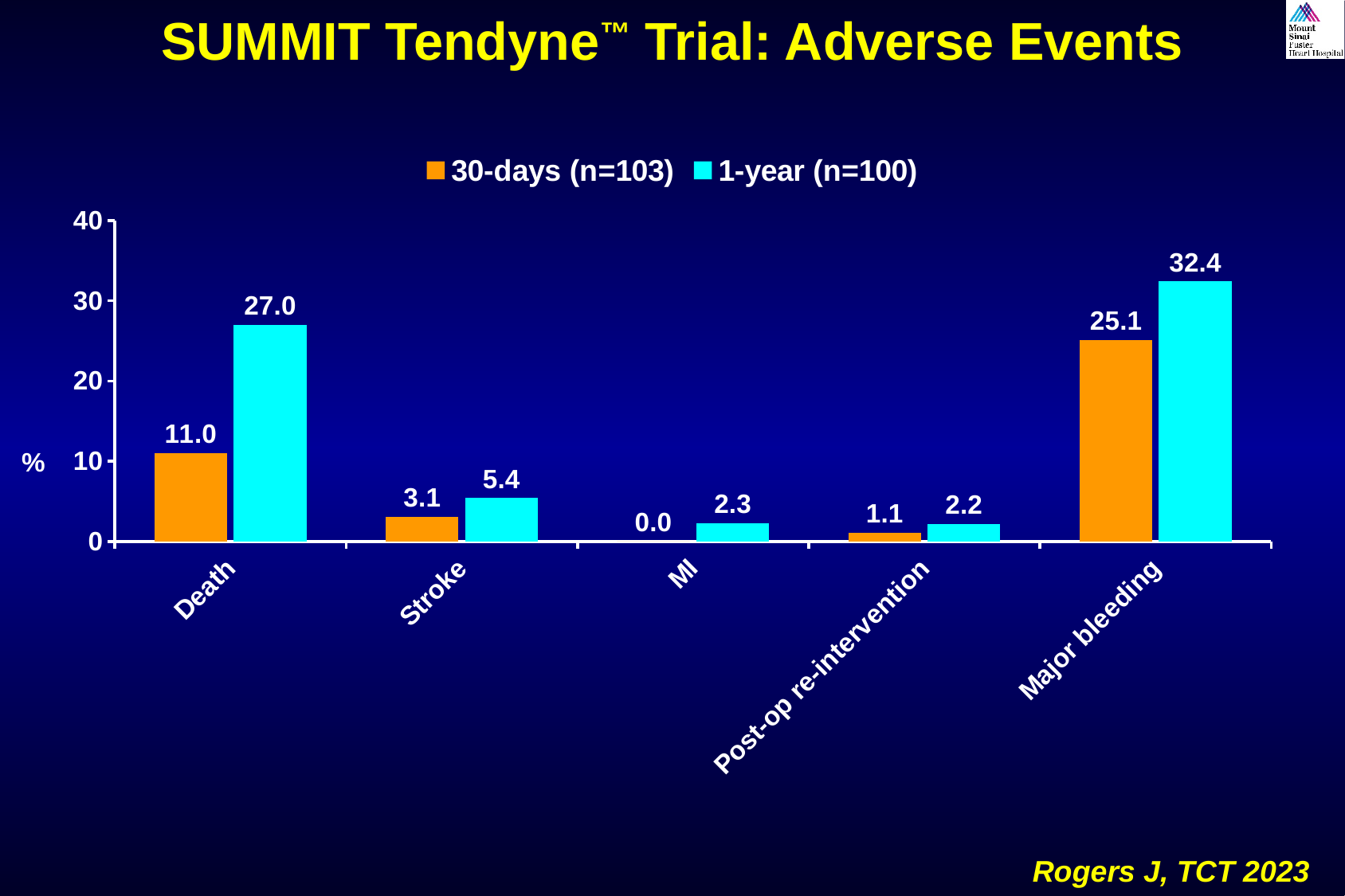
What is the difference between the 1-year and 30-days values for Death? 16.0 How many categories are shown on the x axis? 5 What kind of chart is shown on the slide? Bar chart Which category has the lowest 30-days value? MI What is the 30-days value for Post-op re-intervention? 1.1 What is the title of the slide? SUMMIT Tendyne Trial: Adverse Events What is the 1-year value for Major bleeding? 32.4 What is the 1-year value for MI? 2.3 Which is larger, the 1-year value for Stroke or the 1-year value for MI? 1-year value for Stroke What is the 30-days value for Death? 11.0 How many series does the legend list? 2 Which category has the highest 1-year value? Major bleeding